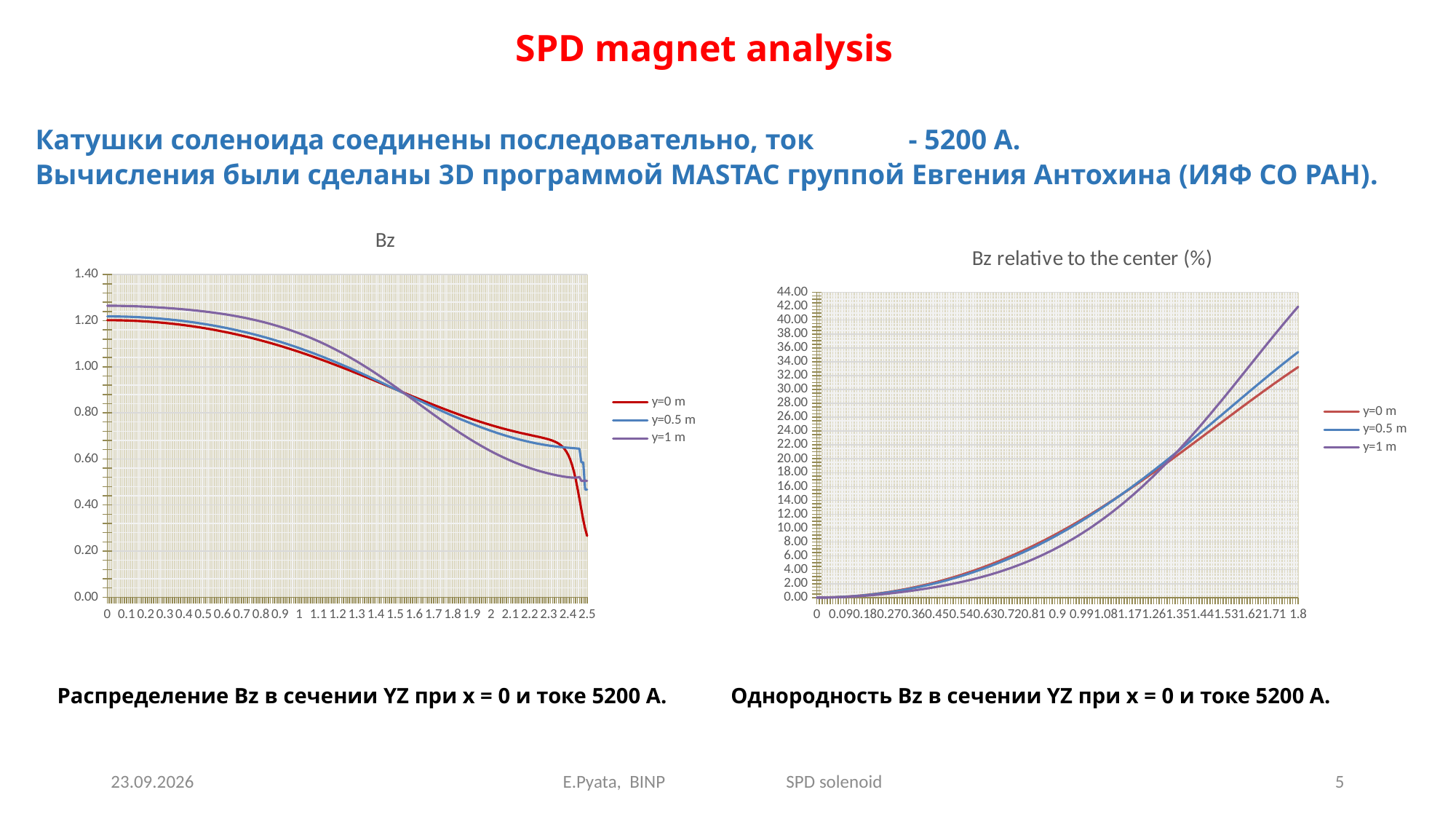
In the "Bz" chart, which series has the highest value at x = 0? y=1 m In the "Bz" chart, is the value of the y=1 m series at x = 2 greater or less than 0.80? less What is the title of the right chart? Bz relative to the center (%) In the "Bz" chart, do the values generally rise or fall along the x axis? fall In the "Bz" chart, which series has the lowest value at x = 2.5? y=0 m In the "Bz relative to the center (%)" chart, which series has the highest value at x = 1.8? y=1 m In the "Bz relative to the center (%)" chart, at x = 0.9, which is larger: the y=0 m series or the y=1 m series? y=0 m In the "Bz relative to the center (%)" chart, is the value of the y=1 m series at x = 1.8 greater or less than 40.00? greater How many series does the legend of the "Bz" chart list? 3 In the "Bz relative to the center (%)" chart, do the values rise or fall along the x axis? rise What kind of chart is the left chart titled "Bz"? line chart In the "Bz" chart, is the value of the y=0 m series at x = 0 greater or less than 1.00? greater